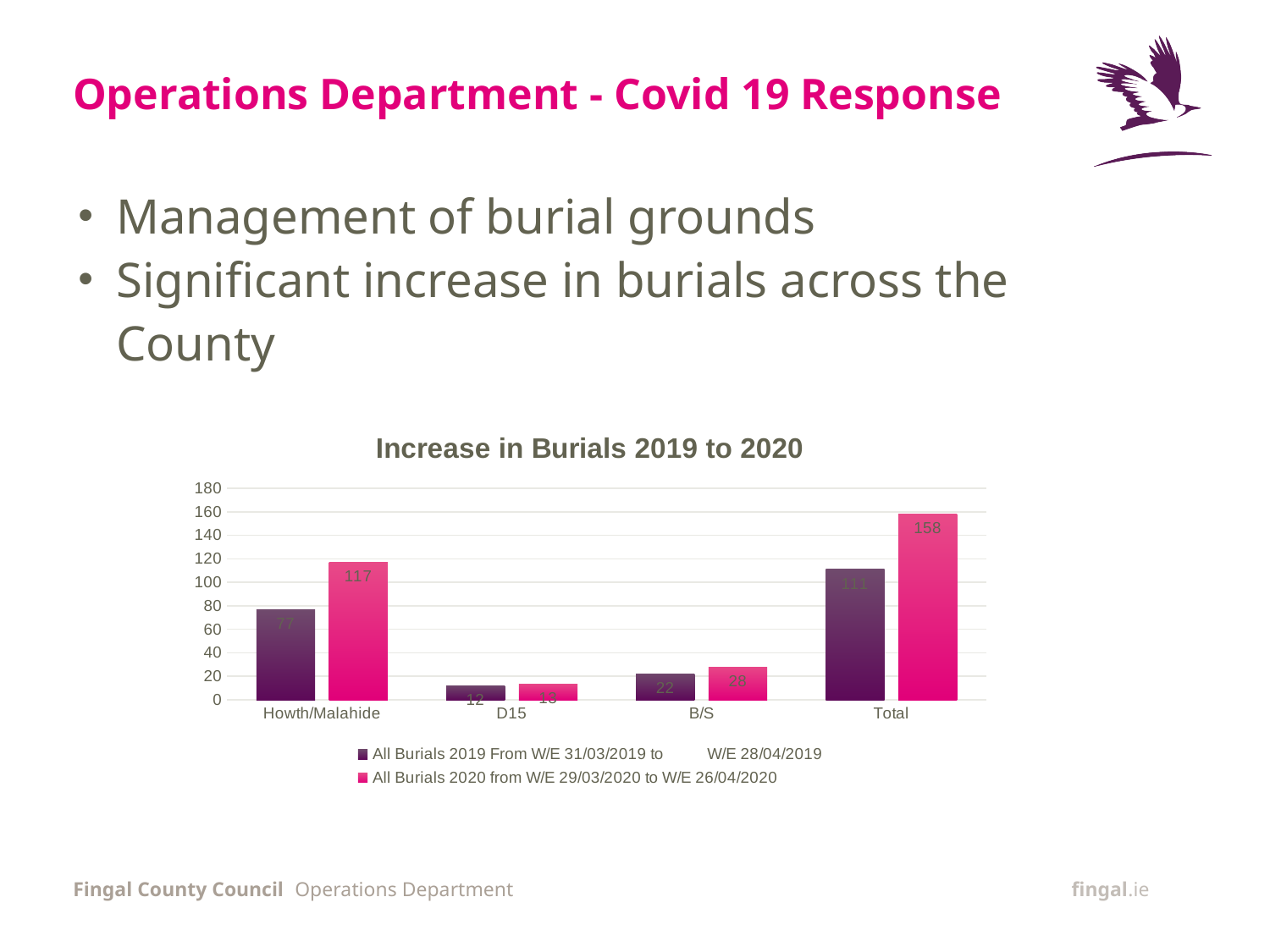
What is the difference between the 2020 and 2019 Total values? 47 Is the 2019 value for B/S greater or less than 40? less How many categories are shown on the x axis? 4 Which is larger for B/S: the 2019 value or the 2020 value? 2020 Excluding Total, which category has the highest value in the 2020 burials series? Howth/Malahide What is the value for Howth/Malahide in the 2019 burials series? 77 What is the Total value for the 2020 burials series? 158 What is the Total value for the 2019 burials series? 111 What is the value for B/S in the 2020 burials series? 28 What is the value for Howth/Malahide in the 2020 burials series? 117 Excluding Total, which category has the lowest value in the 2019 burials series? D15 What kind of chart is shown on the slide? bar chart